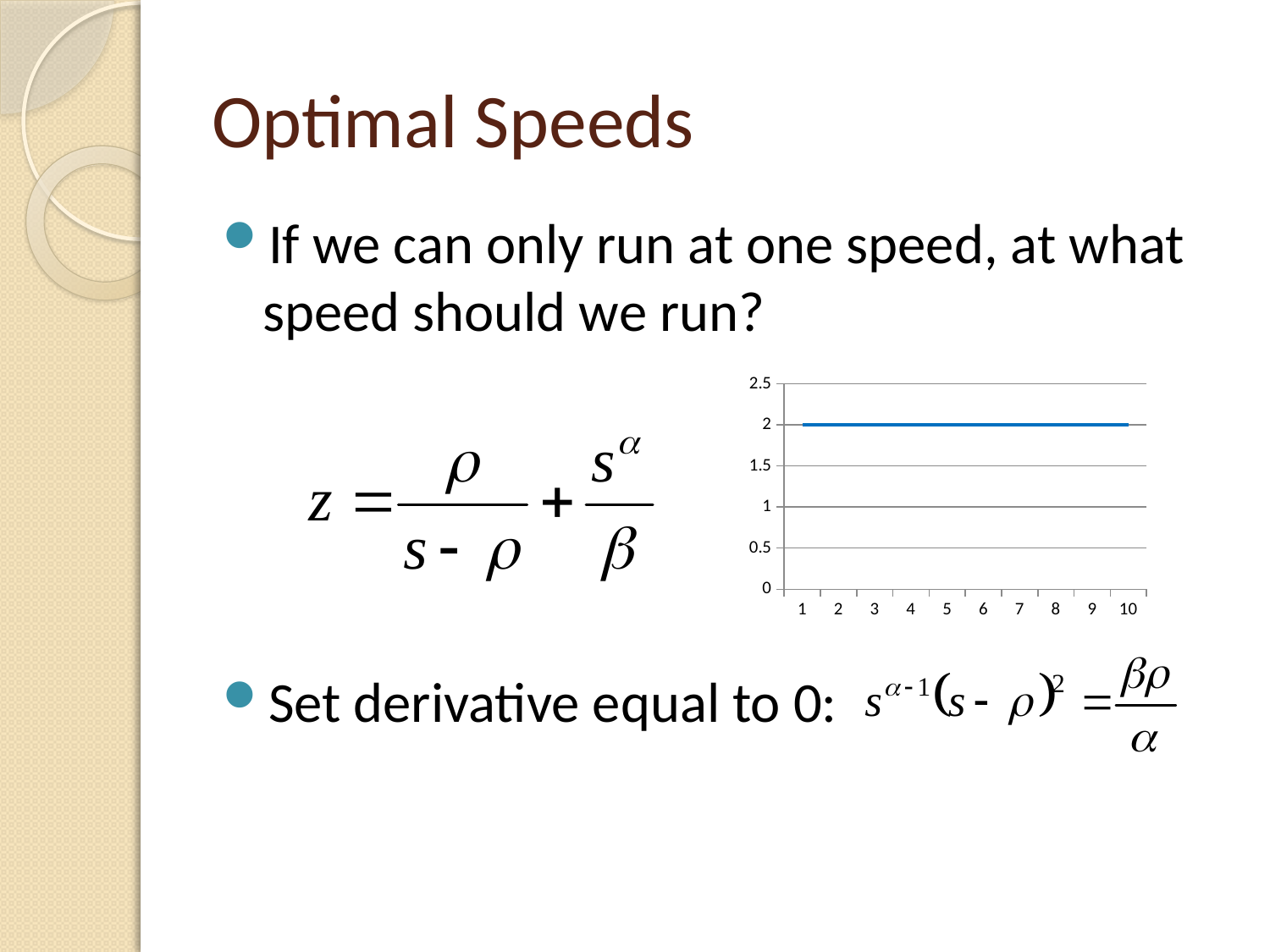
What is the value of the line at x = 1? 2 What is the value of the line at x = 10? 2 What colour is the plotted line? blue What kind of chart is shown on the slide? line chart Does the plotted line rise, fall, or stay flat as x increases from 1 to 10? stays flat How many x-axis categories are labelled on the chart? 10 Is the value of the line at x = 8 greater or less than 2.5? less What is the highest value shown on the y axis? 2.5 Is the value of the line at x = 5 greater or less than 1.5? greater Is the value of the line at x = 3 greater or less than 1? greater